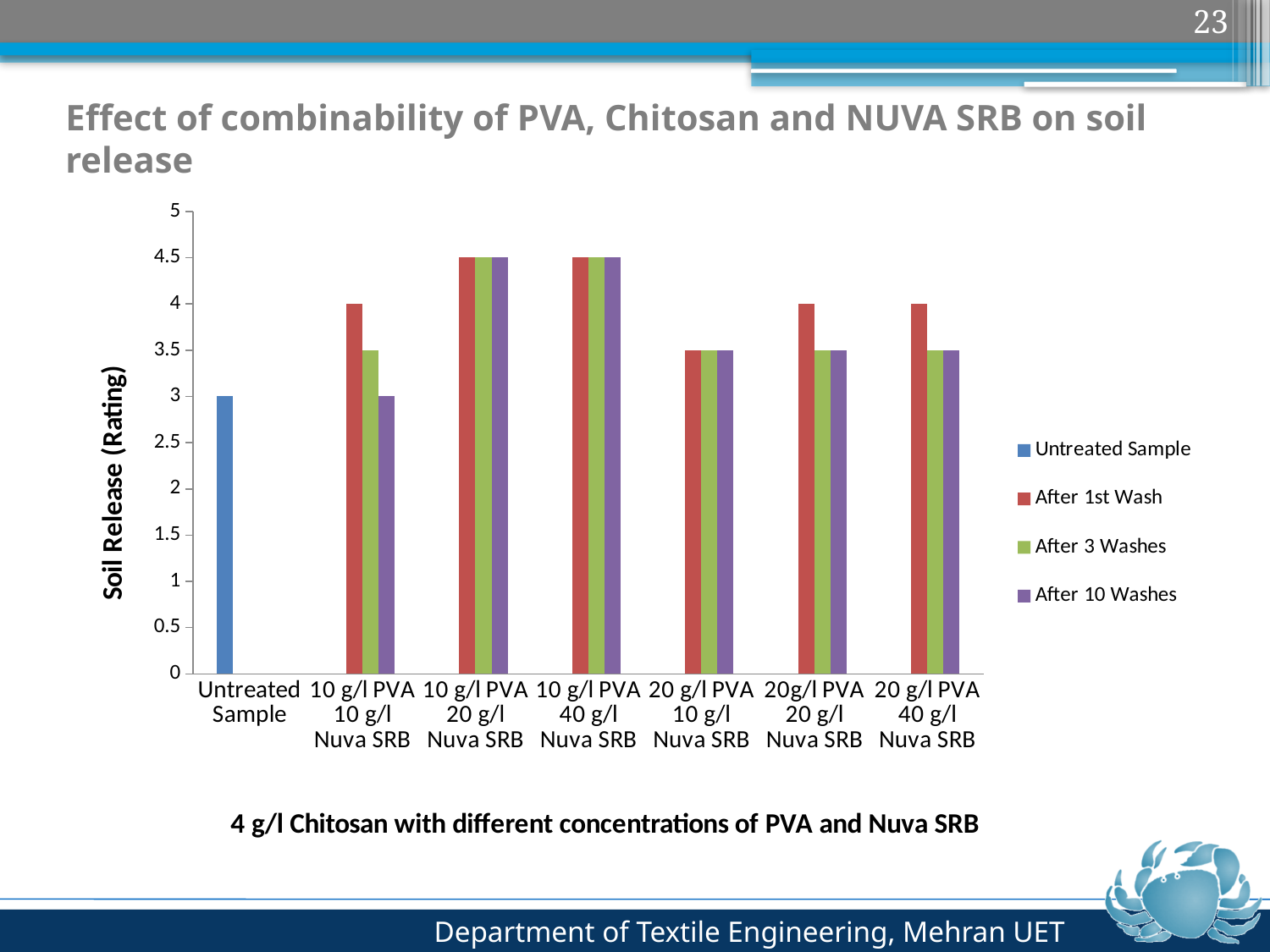
What is the label of the y axis? Soil Release (Rating) What is the soil release rating After 10 Washes for 10 g/l PVA 10 g/l Nuva SRB? 3 What is the soil release rating After 1st Wash for 20 g/l PVA 10 g/l Nuva SRB? 3.5 What is the soil release rating of the Untreated Sample? 3 What is the soil release rating After 3 Washes for 10 g/l PVA 20 g/l Nuva SRB? 4.5 What kind of chart is shown on the slide? Bar chart What is the soil release rating After 1st Wash for 10 g/l PVA 10 g/l Nuva SRB? 4 Which is larger: the After 1st Wash rating for 10 g/l PVA 40 g/l Nuva SRB or for 20 g/l PVA 40 g/l Nuva SRB? 10 g/l PVA 40 g/l Nuva SRB How many categories are shown on the x axis? 7 What is the difference between the After 1st Wash and After 10 Washes ratings for 10 g/l PVA 10 g/l Nuva SRB? 1 Is the After 3 Washes rating for 20 g/l PVA 20 g/l Nuva SRB greater or less than 4? less How many series does the legend list? 4